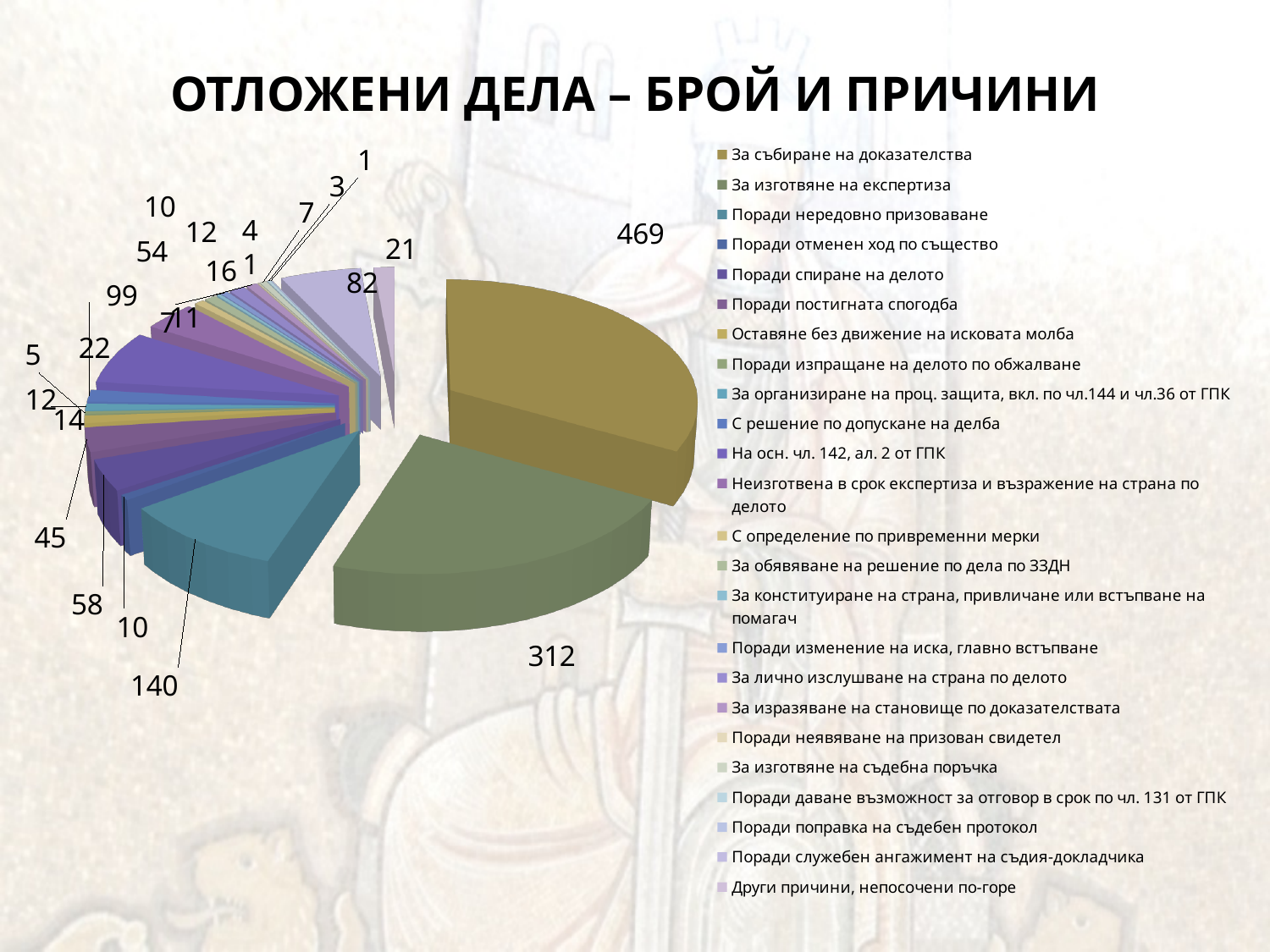
Which category has the largest slice in the pie chart? За събиране на доказателства What is the title of the chart on the slide? ОТЛОЖЕНИ ДЕЛА – БРОЙ И ПРИЧИНИ What is the value of the largest slice in the pie chart? 469 How many categories does the legend of the pie chart list? 24 What is the first entry listed in the chart's legend? За събиране на доказателства What is the difference between the values for 'За събиране на доказателства' and 'За изготвяне на експертиза'? 157 What is the difference between the values for 'За изготвяне на експертиза' and 'Поради нередовно призоваване'? 172 What kind of chart is shown on the slide? pie chart What is the value for 'За изготвяне на експертиза'? 312 Which is larger: the value for 'За изготвяне на експертиза' or the value for 'Поради нередовно призоваване'? За изготвяне на експертиза What is the smallest data label value shown on the pie chart? 1 What is the value for 'Поради нередовно призоваване'? 140